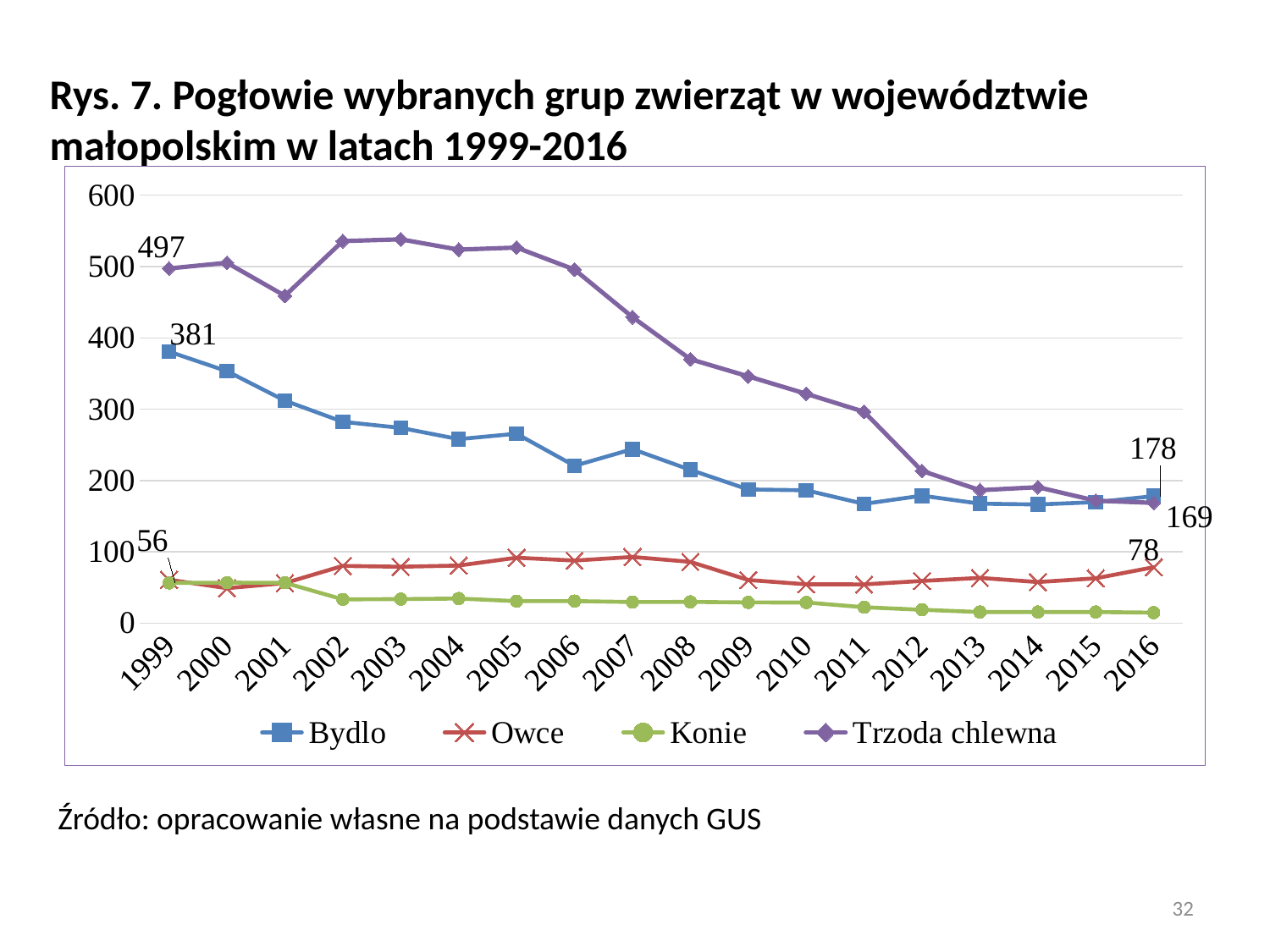
By how much did the value for Bydlo fall between 1999 and 2016? 203 Is the value for Trzoda chlewna in 2003 greater or less than 500? greater What is the value for Trzoda chlewna in 1999? 497 What is the value for Trzoda chlewna in 2016? 169 What is the value for Bydlo in 2016? 178 In 2016, which is larger: the value for Bydlo or the value for Trzoda chlewna? Bydlo What kind of chart is shown on the slide? line chart How many series does the legend list? 4 How many years are shown on the x axis? 18 What is the value for Owce in 2016? 78 What is the value for Bydlo in 1999? 381 What is the difference between the Trzoda chlewna values in 1999 and 2016? 328